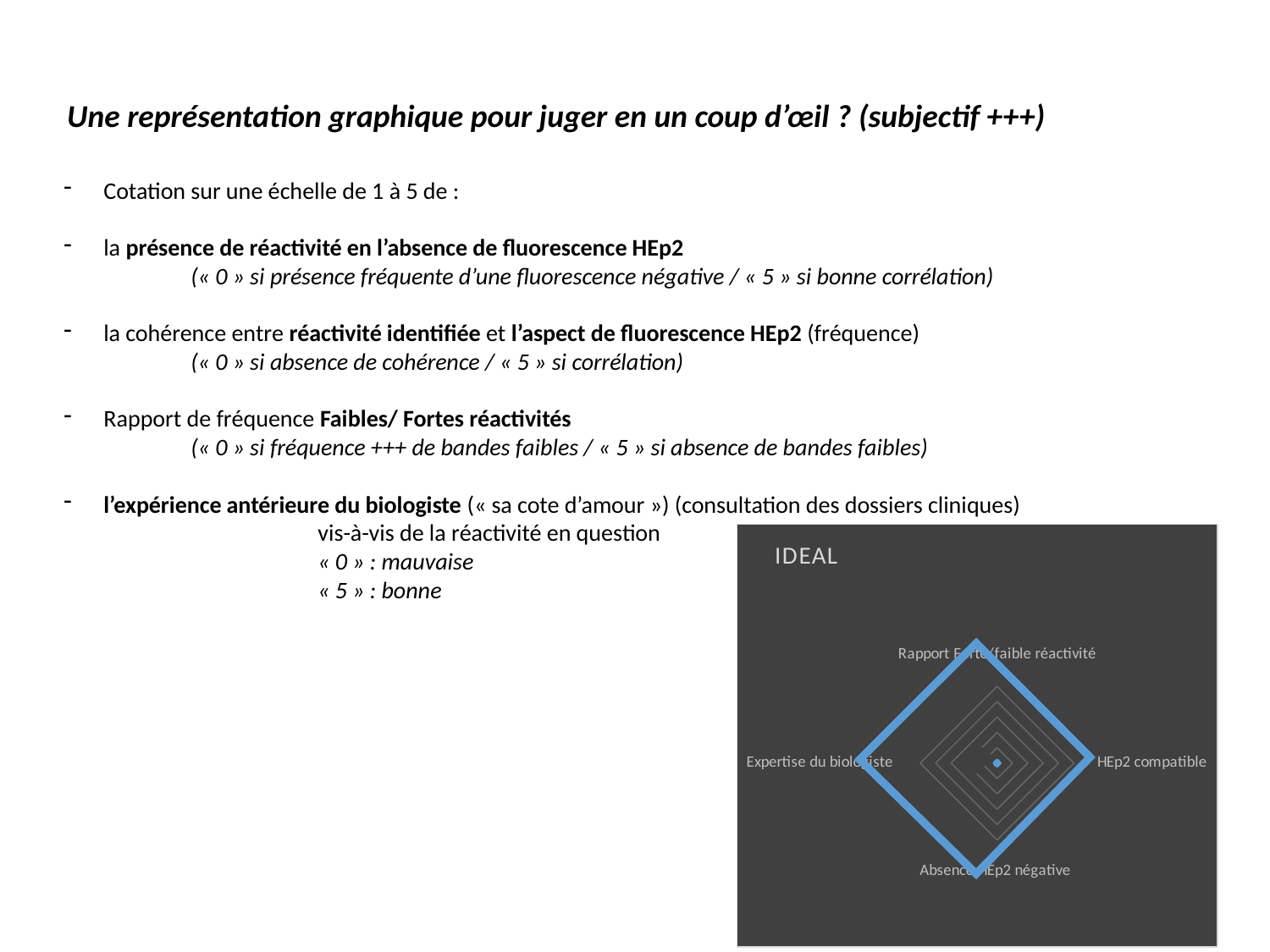
What is the title of the chart on the slide? IDEAL How many axes (categories) does the radar chart have? 4 Which category label appears on the right-hand axis of the radar chart? HEp2 compatible What kind of chart is shown on the slide? Radar chart What colour is the plotted series line on the radar chart? Blue